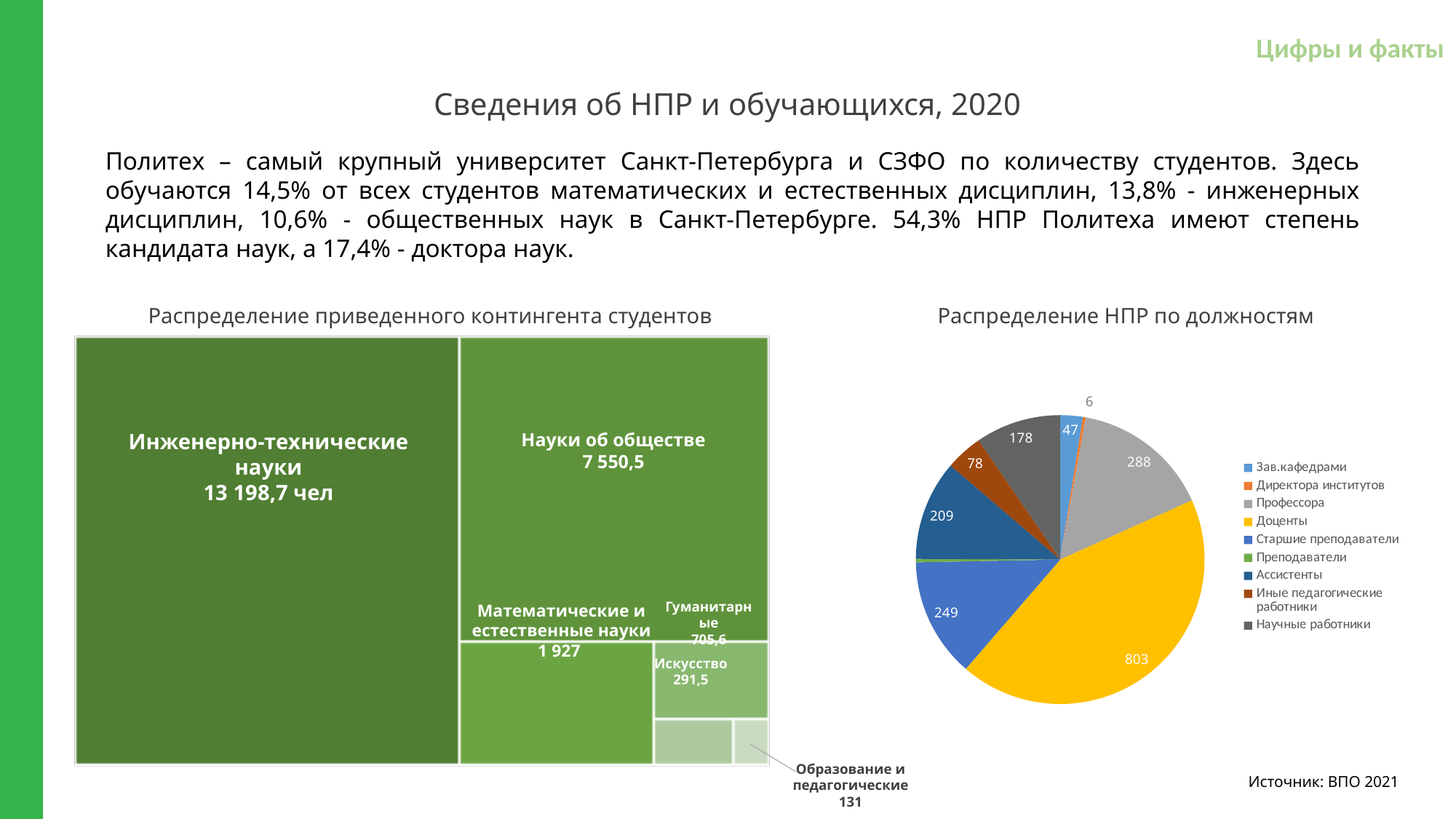
In the chart 'Распределение приведенного контингента студентов', what is the value for Науки об обществе? 7 550,5 In the chart 'Распределение приведенного контингента студентов', what is the value for Образование и педагогические? 131 In the pie chart 'Распределение НПР по должностям', what is the value for Директора институтов? 6 In the pie chart 'Распределение НПР по должностям', which is larger: Ассистенты or Старшие преподаватели? Старшие преподаватели In the chart 'Распределение приведенного контингента студентов', which category has the largest value? Инженерно-технические науки In the pie chart 'Распределение НПР по должностям', what is the value for Доценты? 803 In the pie chart 'Распределение НПР по должностям', what is the difference between the values for Профессора and Научные работники? 110 In the pie chart 'Распределение НПР по должностям', which position has the largest slice? Доценты How many categories does the legend of the pie chart 'Распределение НПР по должностям' list? 9 What kind of chart is 'Распределение НПР по должностям'? Pie chart In the chart 'Распределение приведенного контингента студентов', what is the value for Инженерно-технические науки? 13 198,7 чел In the pie chart 'Распределение НПР по должностям', what is the value for Профессора? 288